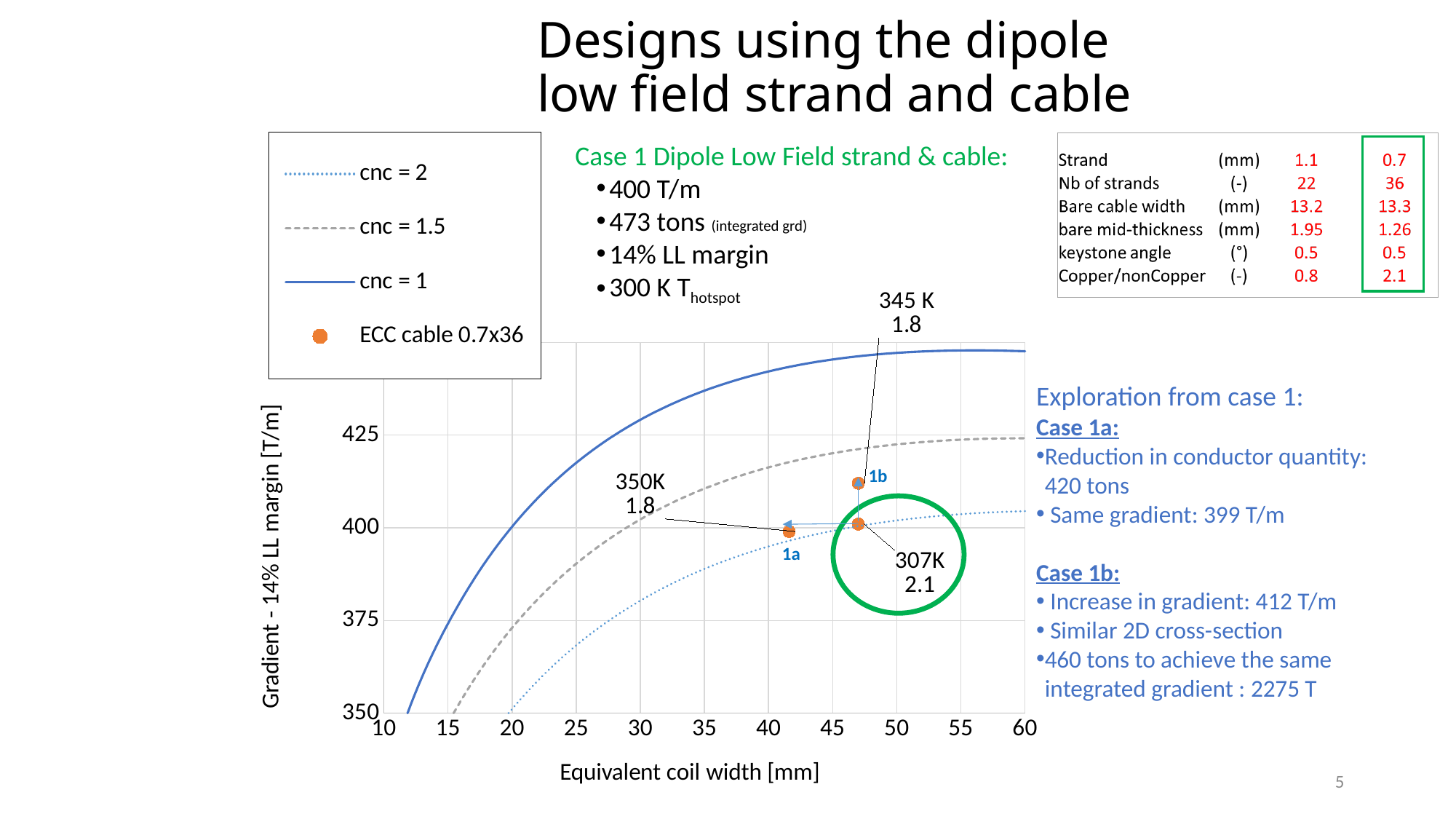
At an equivalent coil width of 40 mm, which curve has the larger value, cnc = 1.5 or cnc = 2? cnc = 1.5 Which curve lies highest on the chart: cnc = 2, cnc = 1.5 or cnc = 1? cnc = 1 What is the title of the x axis of the chart? Equivalent coil width [mm] Is the value of the cnc = 1.5 curve at an equivalent coil width of 50 mm greater or less than 400? greater Which curve lies lowest on the chart: cnc = 2, cnc = 1.5 or cnc = 1? cnc = 2 Do the cnc curves rise or fall as the equivalent coil width increases? rise What is the title of the y axis of the chart? Gradient - 14% LL margin [T/m] What kind of chart is shown on the slide? line chart Is the value of the cnc = 1 curve at an equivalent coil width of 40 mm greater or less than 425? greater How many ECC cable 0.7x36 points are plotted on the chart? 3 How many entries does the chart legend list? 4 Is the value of the cnc = 2 curve at an equivalent coil width of 30 mm greater or less than 400? less